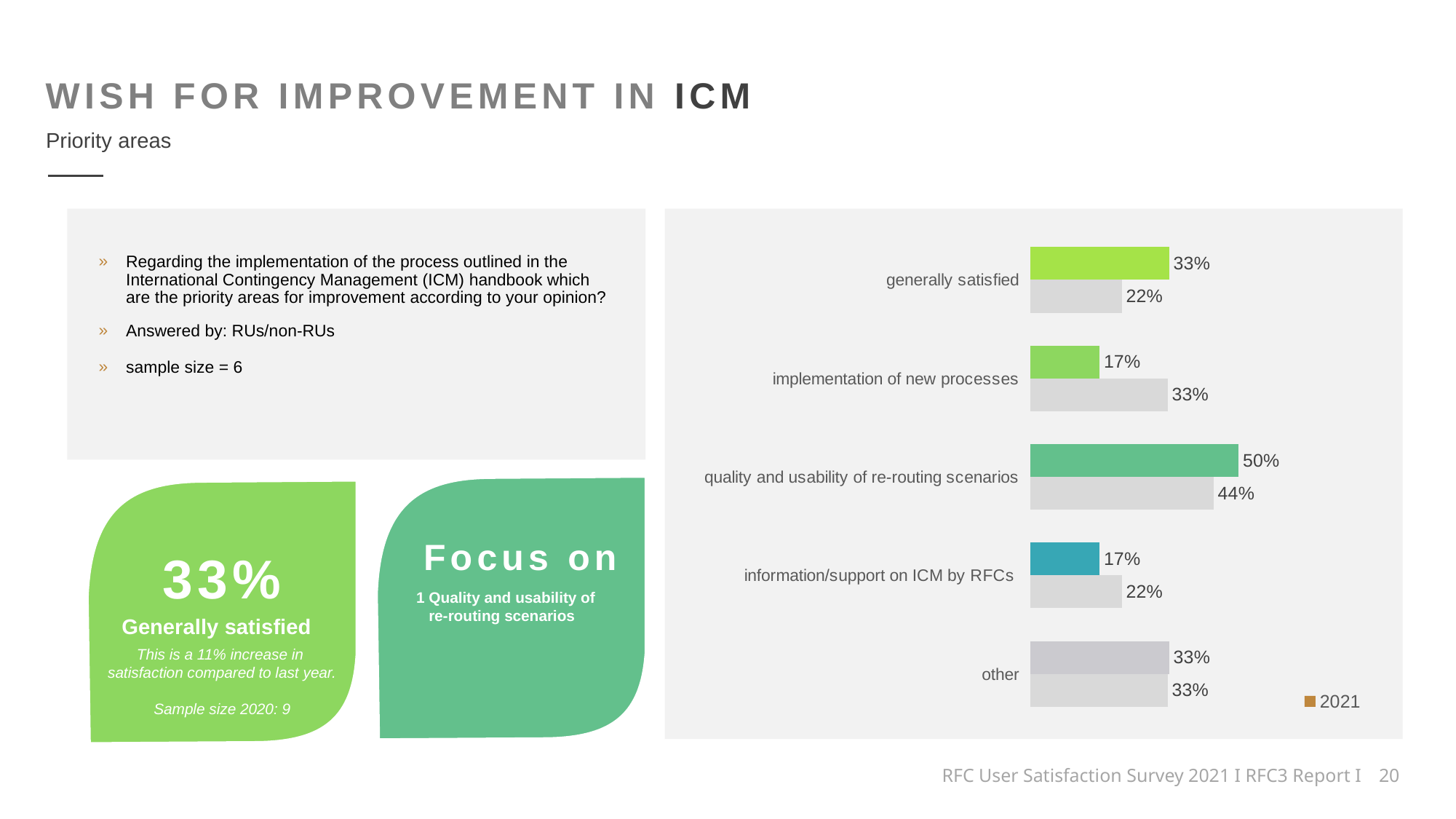
How many categories does the bar chart show? 5 What is the 2021 value for 'quality and usability of re-routing scenarios'? 50% What value is shown on the grey bar for 'quality and usability of re-routing scenarios'? 44% Which category has the highest 2021 value in the bar chart? quality and usability of re-routing scenarios What is the 2021 value for 'generally satisfied' in the bar chart? 33% What is the difference between the 2021 value and the grey bar value for 'generally satisfied'? 11% For 'implementation of new processes', which is larger: the 2021 bar or the grey bar? the grey bar What series name appears in the chart legend? 2021 What kind of chart is shown on the right of the slide? bar chart What is the 2021 value for 'implementation of new processes'? 17% What is the difference between the 2021 values for 'quality and usability of re-routing scenarios' and 'information/support on ICM by RFCs'? 33% How many series does the chart legend list? 1